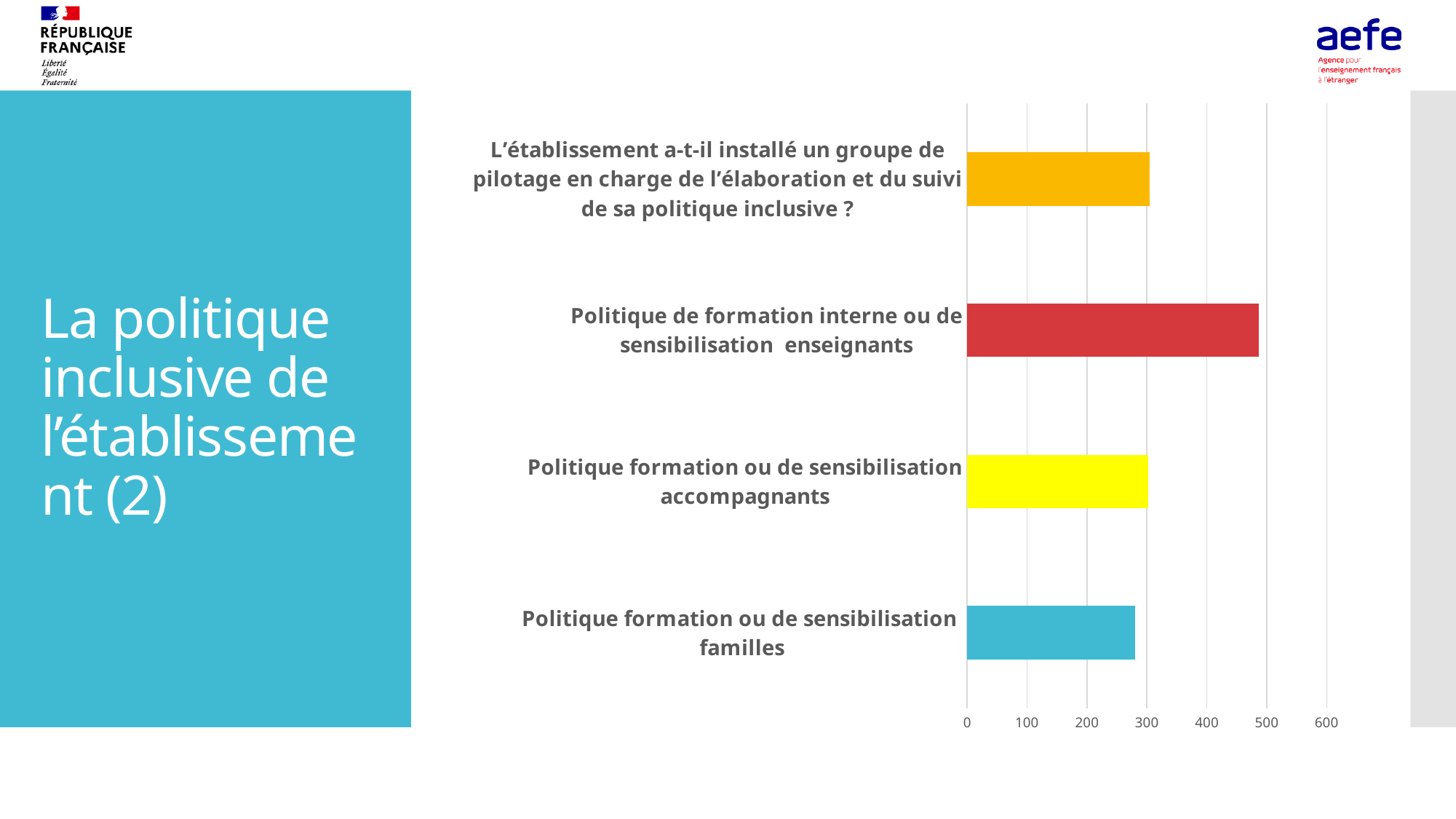
What colour is the bar for "Politique de formation interne ou de sensibilisation enseignants"? red Which is larger: the value for "Politique de formation interne ou de sensibilisation enseignants" or the value for "Politique formation ou de sensibilisation familles"? Politique de formation interne ou de sensibilisation enseignants Which category has the highest value? Politique de formation interne ou de sensibilisation enseignants Is the value for "L'établissement a-t-il installé un groupe de pilotage en charge de l'élaboration et du suivi de sa politique inclusive ?" greater or less than 200? greater Is the value for "Politique formation ou de sensibilisation accompagnants" greater or less than 200? greater Is the value for "Politique formation ou de sensibilisation familles" greater or less than 400? less How many categories does the chart show? 4 Which is larger: the value for "Politique de formation interne ou de sensibilisation enseignants" or the value for "Politique formation ou de sensibilisation accompagnants"? Politique de formation interne ou de sensibilisation enseignants What is the highest value shown on the horizontal axis? 600 What kind of chart is shown on the slide? bar chart